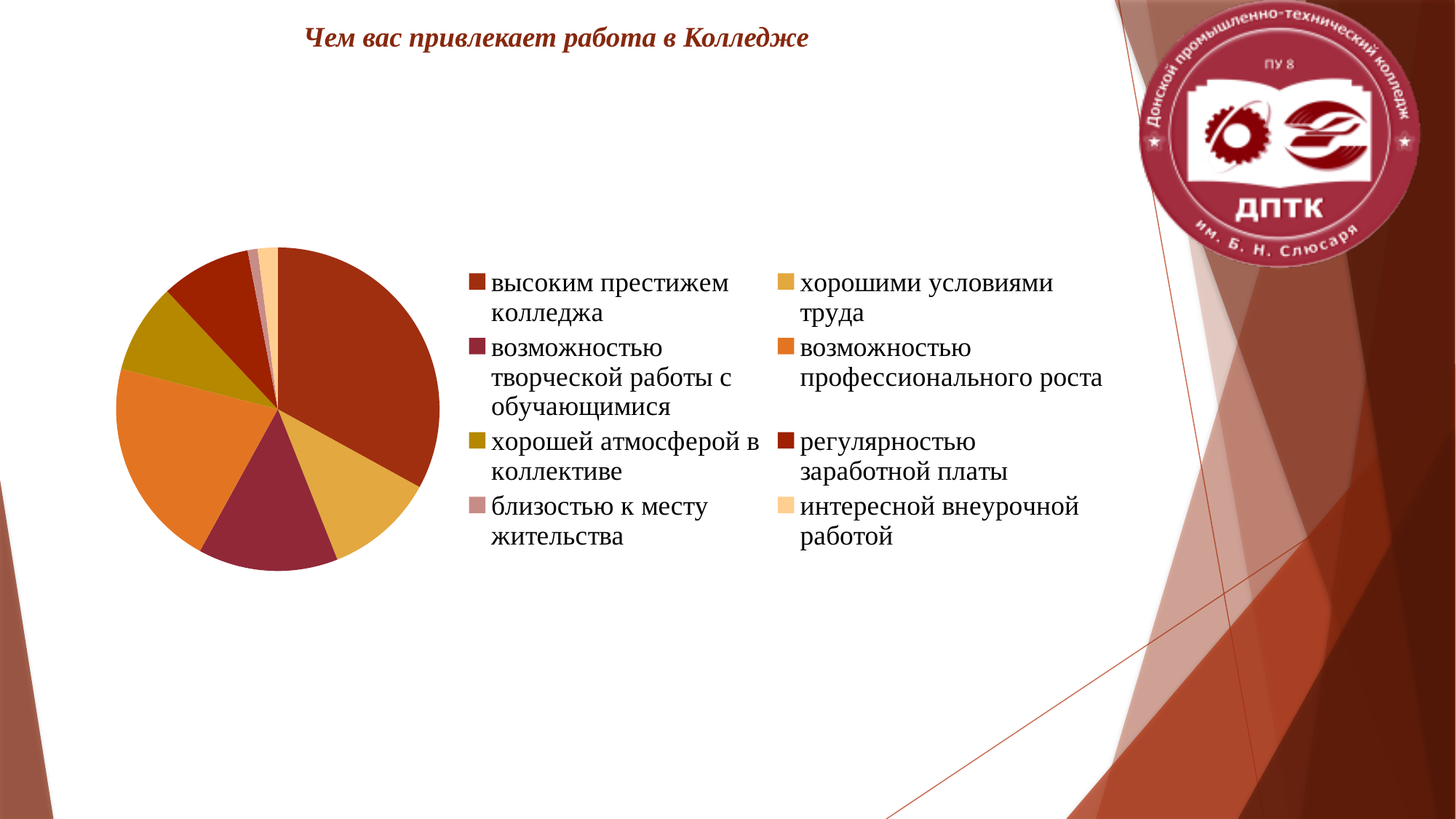
Which slice is larger: 'хорошими условиями труда' or 'интересной внеурочной работой'? хорошими условиями труда Which slice is larger: 'высоким престижем колледжа' or 'возможностью творческой работы с обучающимися'? высоким престижем колледжа What kind of chart is shown on the slide? pie chart Which slice is larger: 'возможностью профессионального роста' or 'хорошей атмосферой в коллективе'? возможностью профессионального роста Which category has the largest slice of the pie chart? высоким престижем колледжа How many categories (slices) does the pie chart have? 8 What is the title of the chart on the slide? Чем вас привлекает работа в Колледже How many entries does the chart legend list? 8 Which category has the smallest slice of the pie chart? близостью к месту жительства